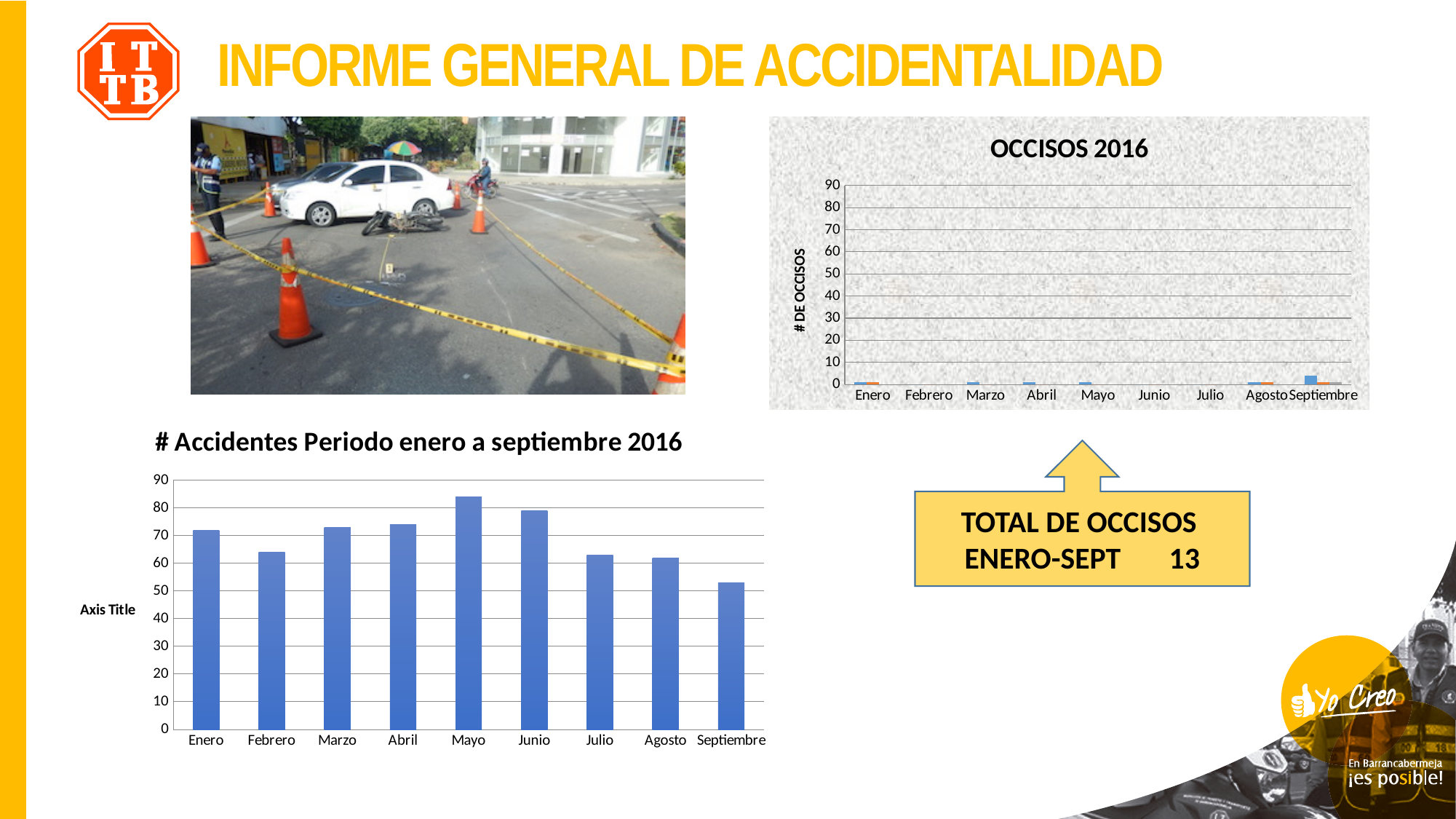
In the '# Accidentes Periodo enero a septiembre 2016' chart, which month has the highest number of accidents? Mayo In the '# Accidentes Periodo enero a septiembre 2016' chart, is the value for Mayo greater or less than 80? greater In the '# Accidentes Periodo enero a septiembre 2016' chart, is the value for Febrero greater or less than 60? greater In the '# Accidentes Periodo enero a septiembre 2016' chart, which month has the lowest number of accidents? Septiembre In the 'OCCISOS 2016' chart, is the value for Septiembre greater or less than 10? less In the 'OCCISOS 2016' chart, which month has the highest value? Septiembre What kind of chart is the '# Accidentes Periodo enero a septiembre 2016' chart? bar chart How many months are shown on the x axis of the '# Accidentes Periodo enero a septiembre 2016' chart? 9 In the '# Accidentes Periodo enero a septiembre 2016' chart, which is larger, the value for Junio or the value for Agosto? Junio In the '# Accidentes Periodo enero a septiembre 2016' chart, do the values rise or fall from Junio to Septiembre? fall What is the y-axis title of the 'OCCISOS 2016' chart? # DE OCCISOS